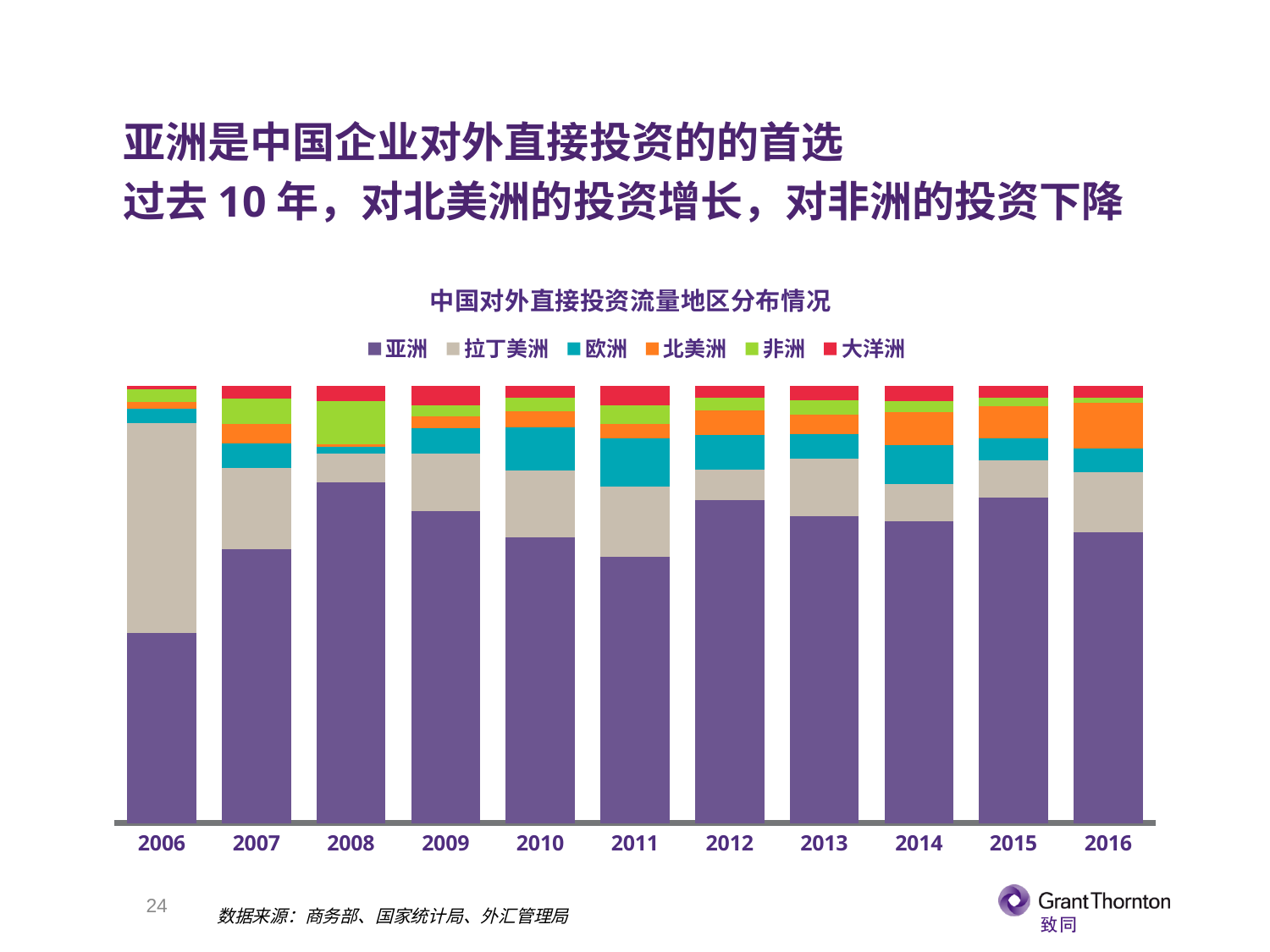
Which region is listed first in the legend? 亚洲 In which year is the 亚洲 segment the smallest? 2006 In which year is the 非洲 segment the largest? 2008 What is the title of the chart? 中国对外直接投资流量地区分布情况 In 2006, which segment is larger: 拉丁美洲 or 欧洲? 拉丁美洲 What kind of chart is shown on the slide? Stacked bar chart How many years are shown on the x axis? 11 How many series does the legend list? 6 In 2016, which segment is larger: 北美洲 or 欧洲? 北美洲 Which year is the first category on the x axis? 2006 In which year is the 拉丁美洲 segment the largest? 2006